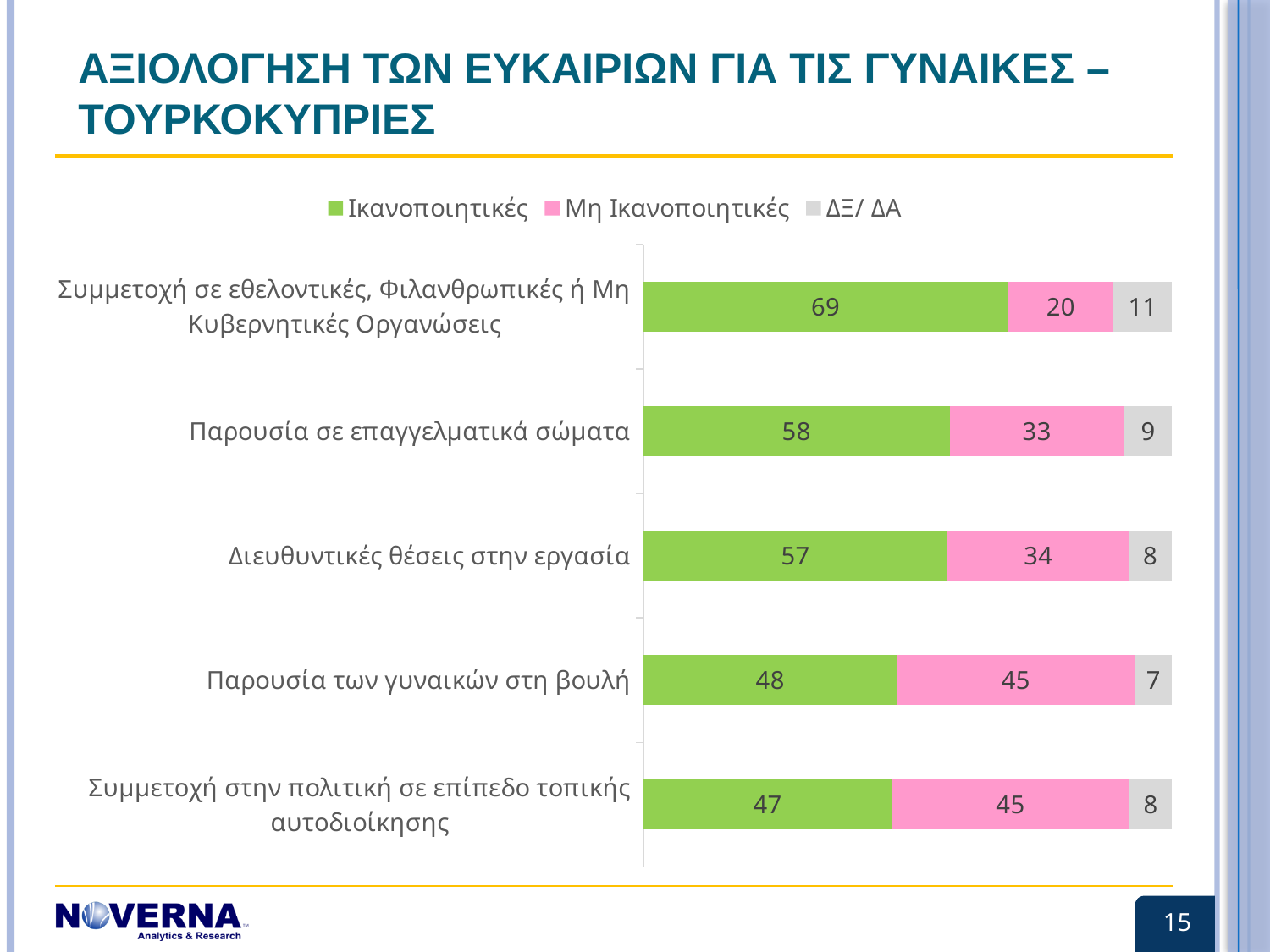
How many series does the legend list? 3 Which colour represents the Μη Ικανοποιητικές series? Pink What is the total of the stacked bar for Παρουσία σε επαγγελματικά σώματα? 100 Which category has the lowest Ικανοποιητικές value? Συμμετοχή στην πολιτική σε επίπεδο τοπικής αυτοδιοίκησης How many categories are shown in the chart? 5 Which category has the highest Ικανοποιητικές value? Συμμετοχή σε εθελοντικές, Φιλανθρωπικές ή Μη Κυβερνητικές Οργανώσεις What is the value of ΔΞ/ ΔΑ for Παρουσία των γυναικών στη βουλή? 7 Which is larger for Παρουσία των γυναικών στη βουλή: Ικανοποιητικές or Μη Ικανοποιητικές? Ικανοποιητικές What is the value of Μη Ικανοποιητικές for Παρουσία σε επαγγελματικά σώματα? 33 What is the value of Ικανοποιητικές for Συμμετοχή σε εθελοντικές, Φιλανθρωπικές ή Μη Κυβερνητικές Οργανώσεις? 69 What is the difference between the Ικανοποιητικές and Μη Ικανοποιητικές values for Διευθυντικές θέσεις στην εργασία? 23 What kind of chart is shown on the slide? Stacked bar chart